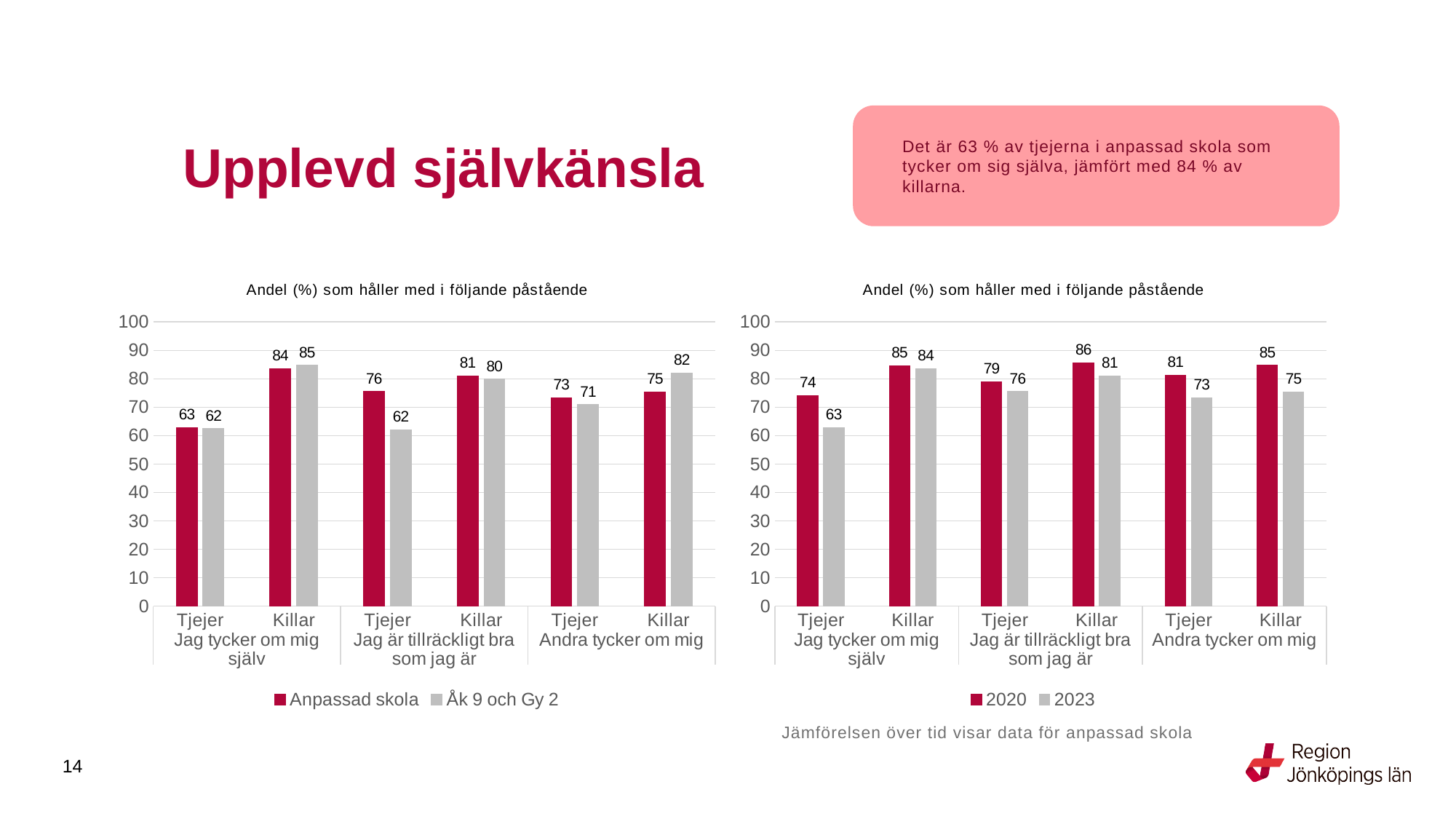
On the right chart, what is the difference between the 2020 and 2023 values for Tjejer under 'Jag tycker om mig själv'? 11 On the left chart, what is the value for Åk 9 och Gy 2 for Tjejer under 'Jag är tillräckligt bra som jag är'? 62 What are the two legend entries of the left chart? Anpassad skola and Åk 9 och Gy 2 On the right chart, what is the 2023 value for Killar under 'Andra tycker om mig'? 75 On the right chart, which category has the highest 2020 value? Killar, Jag är tillräckligt bra som jag är How many series does the legend of the right chart list? 2 What kind of chart is the left chart? Bar chart On the right chart, is the 2023 value for Tjejer under 'Jag tycker om mig själv' greater or less than 70? less On the left chart, what is the value for Anpassad skola for Tjejer under 'Jag tycker om mig själv'? 63 On the left chart, what is the difference between Anpassad skola and Åk 9 och Gy 2 for Tjejer under 'Jag är tillräckligt bra som jag är'? 14 On the left chart, under 'Andra tycker om mig', is the Killar value larger for Anpassad skola or for Åk 9 och Gy 2? Åk 9 och Gy 2 On the left chart, which category has the lowest Åk 9 och Gy 2 value? Tjejer, Jag tycker om mig själv and Tjejer, Jag är tillräckligt bra som jag är (both 62)